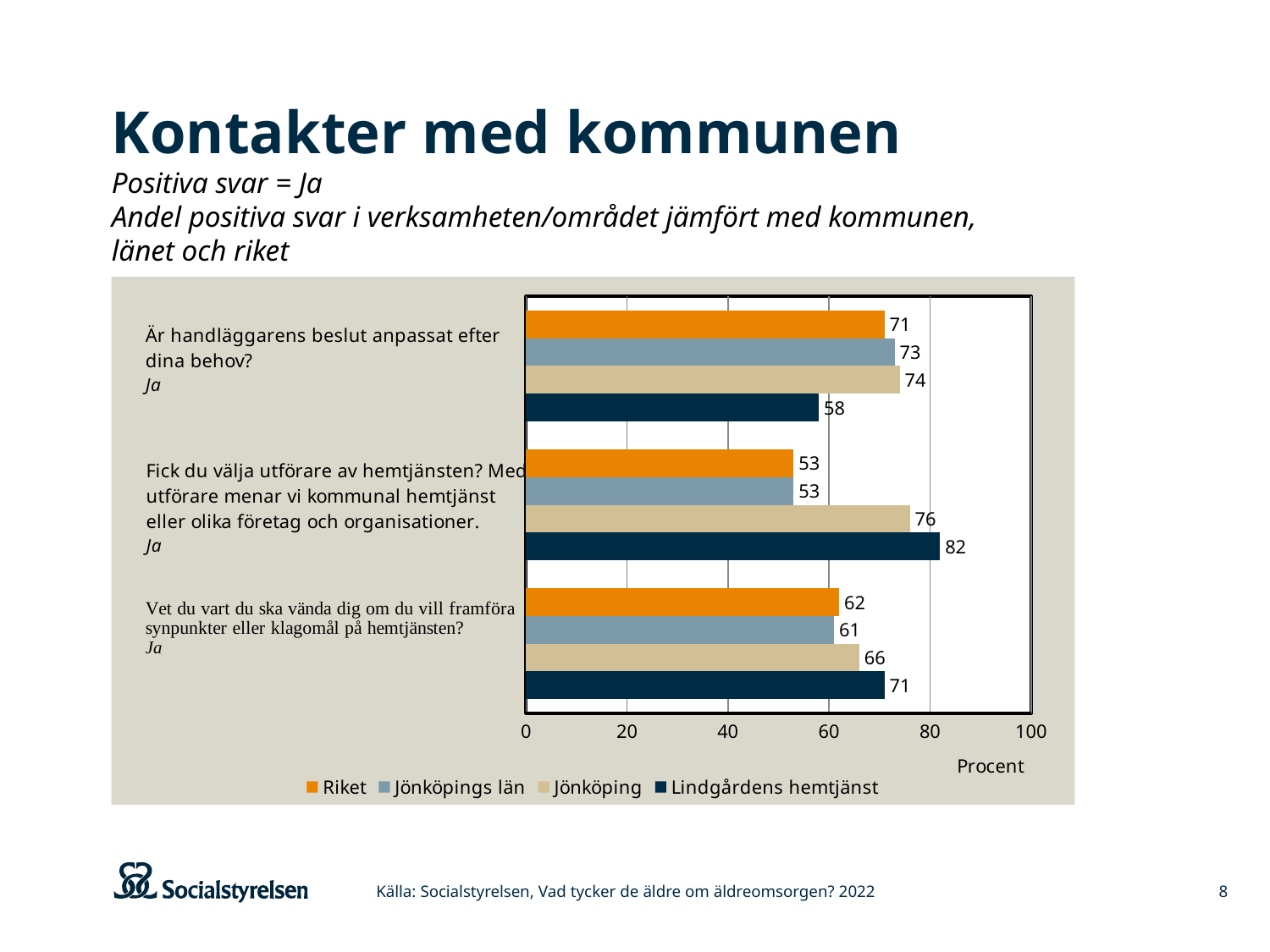
How many series does the legend list? 4 What is the value for Jönköping on the question "Fick du välja utförare av hemtjänsten?"? 76 Is the value for Lindgårdens hemtjänst on the question "Fick du välja utförare av hemtjänsten?" greater or less than 80? greater Which series has the lowest value on the question "Är handläggarens beslut anpassat efter dina behov?"? Lindgårdens hemtjänst On the question "Vet du vart du ska vända dig om du vill framföra synpunkter eller klagomål på hemtjänsten?", which is larger: Jönköping or Lindgårdens hemtjänst? Lindgårdens hemtjänst What kind of chart is shown on the slide? bar chart What is the value for Riket on the question "Vet du vart du ska vända dig om du vill framföra synpunkter eller klagomål på hemtjänsten?"? 62 Which series has the highest value on the question "Fick du välja utförare av hemtjänsten?"? Lindgårdens hemtjänst How many questions (categories) are shown in the chart? 3 What is the value for Lindgårdens hemtjänst on the question "Är handläggarens beslut anpassat efter dina behov?"? 58 What is the difference between Lindgårdens hemtjänst and Riket on the question "Fick du välja utförare av hemtjänsten?"? 29 What unit is labelled on the horizontal axis of the chart? Procent